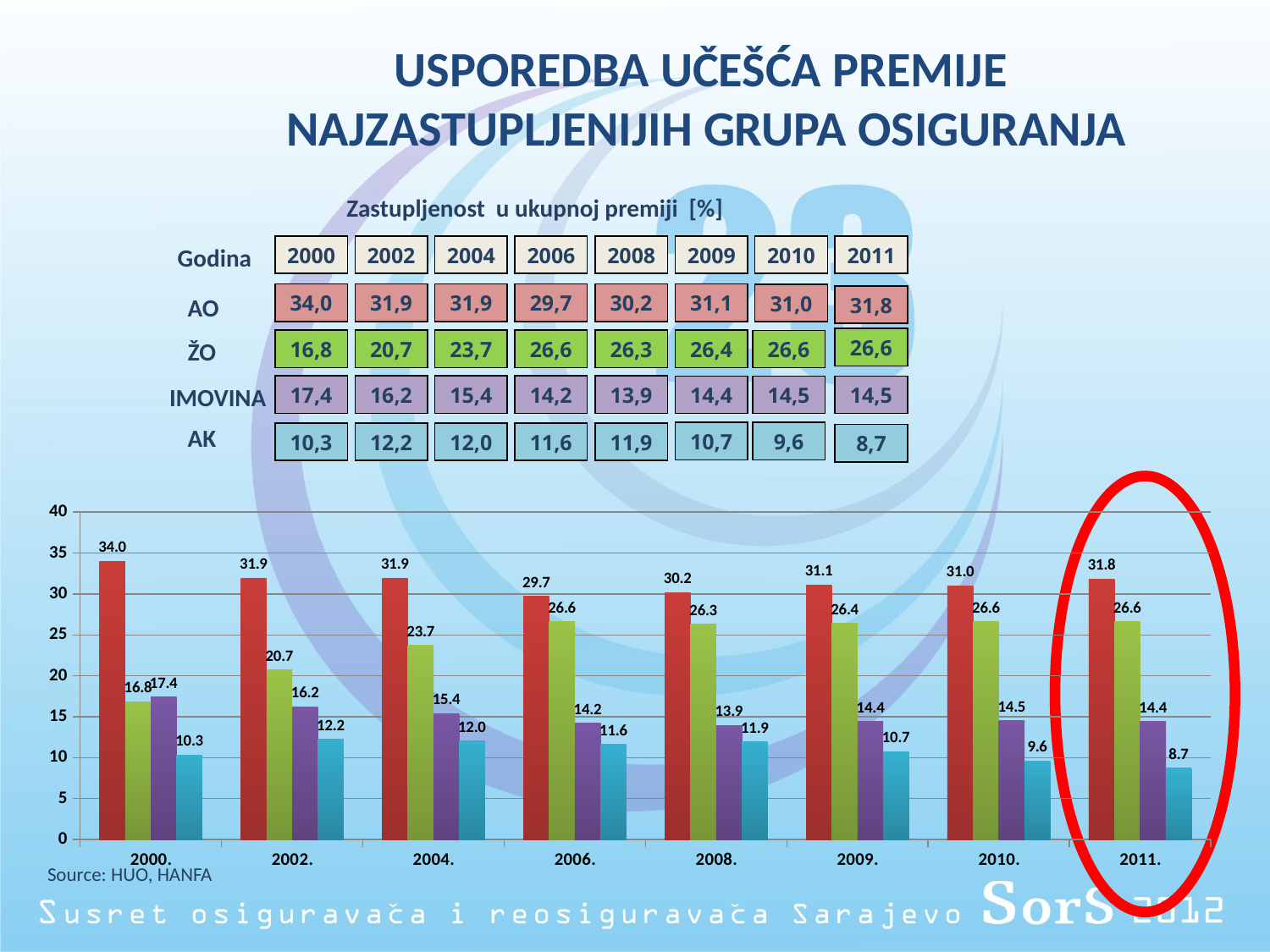
What kind of chart is shown on the slide? bar chart How many year groups are shown on the x axis of the bar chart? 8 In which year is the blue (AK) bar lowest in the bar chart? 2011. How many bars are shown for each year in the bar chart? 4 What is the value of the green (ŽO) bar for 2004. in the bar chart? 23.7 What is the difference between the red (AO) bar and the green (ŽO) bar for 2011. in the bar chart? 5.2 What is the value of the red (AO) bar for 2000. in the bar chart? 34.0 In which year does the red (AO) bar reach its highest value in the bar chart? 2000. In the bar chart, which is larger for 2000.: the green (ŽO) bar or the purple (IMOVINA) bar? the purple (IMOVINA) bar Is the value of the red (AO) bar for 2006. greater or less than 30 in the bar chart? less What is the value of the blue (AK) bar for 2011. in the bar chart? 8.7 Does the blue (AK) bar rise or fall from 2008. to 2011. in the bar chart? fall